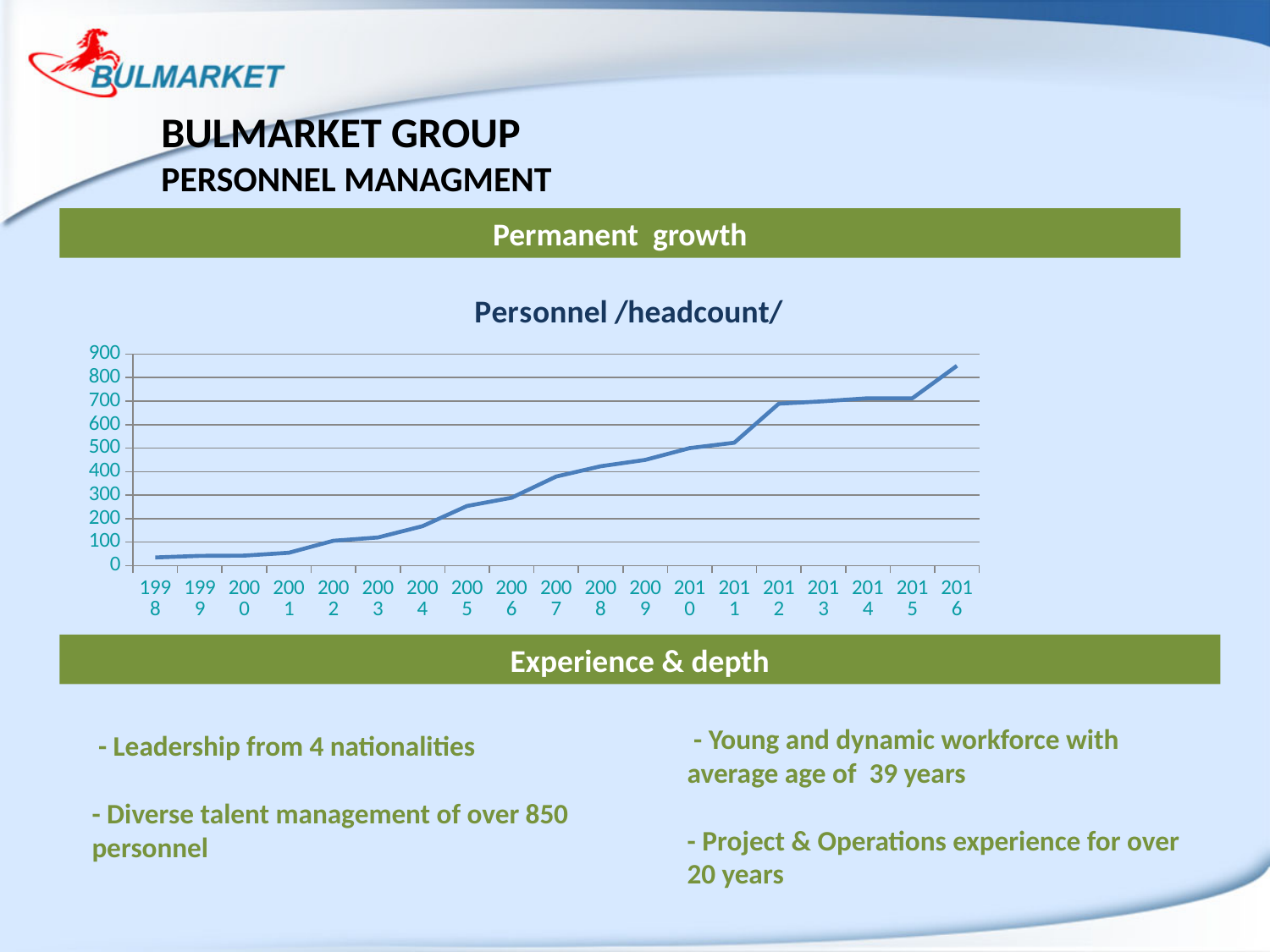
Is the headcount for 1998 greater or less than 100? less Is the headcount for 2016 greater or less than 800? greater Is the headcount for 2005 greater or less than 300? less Does the headcount generally rise or fall from 1998 to 2016? rise How many years are plotted on the x axis of the chart? 19 What is the title of the chart? Personnel /headcount/ What type of chart is shown on the slide? line chart Which year has the highest headcount in the chart? 2016 Which year has the larger headcount, 2011 or 2012? 2012